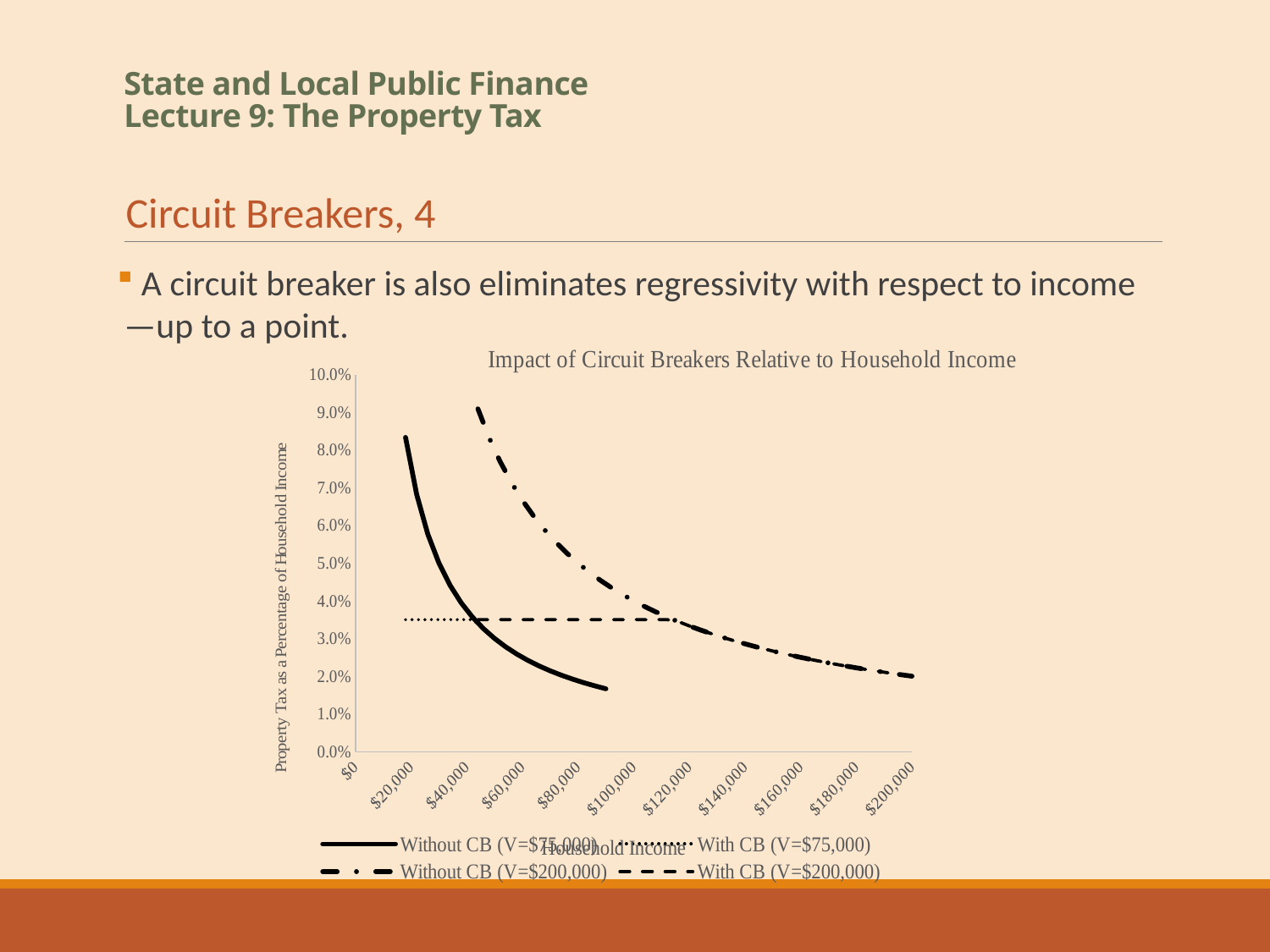
Is the value for Without CB (V=$200,000) at $80,000 household income greater or less than 4.0%? greater What is the label on the vertical axis of the chart? Property Tax as a Percentage of Household Income Does the Without CB (V=$200,000) line rise or fall as household income increases? fall What is the title of the chart? Impact of Circuit Breakers Relative to Household Income Is the value for Without CB (V=$75,000) at $20,000 household income greater or less than 7.0%? greater Is the value for With CB (V=$75,000) at $60,000 household income greater or less than 4.0%? less How many series does the legend list? 4 At $60,000 household income, which is larger: Without CB (V=$200,000) or Without CB (V=$75,000)? Without CB (V=$200,000) Does the Without CB (V=$75,000) line rise or fall as household income increases? fall What kind of chart is shown on the slide? line chart